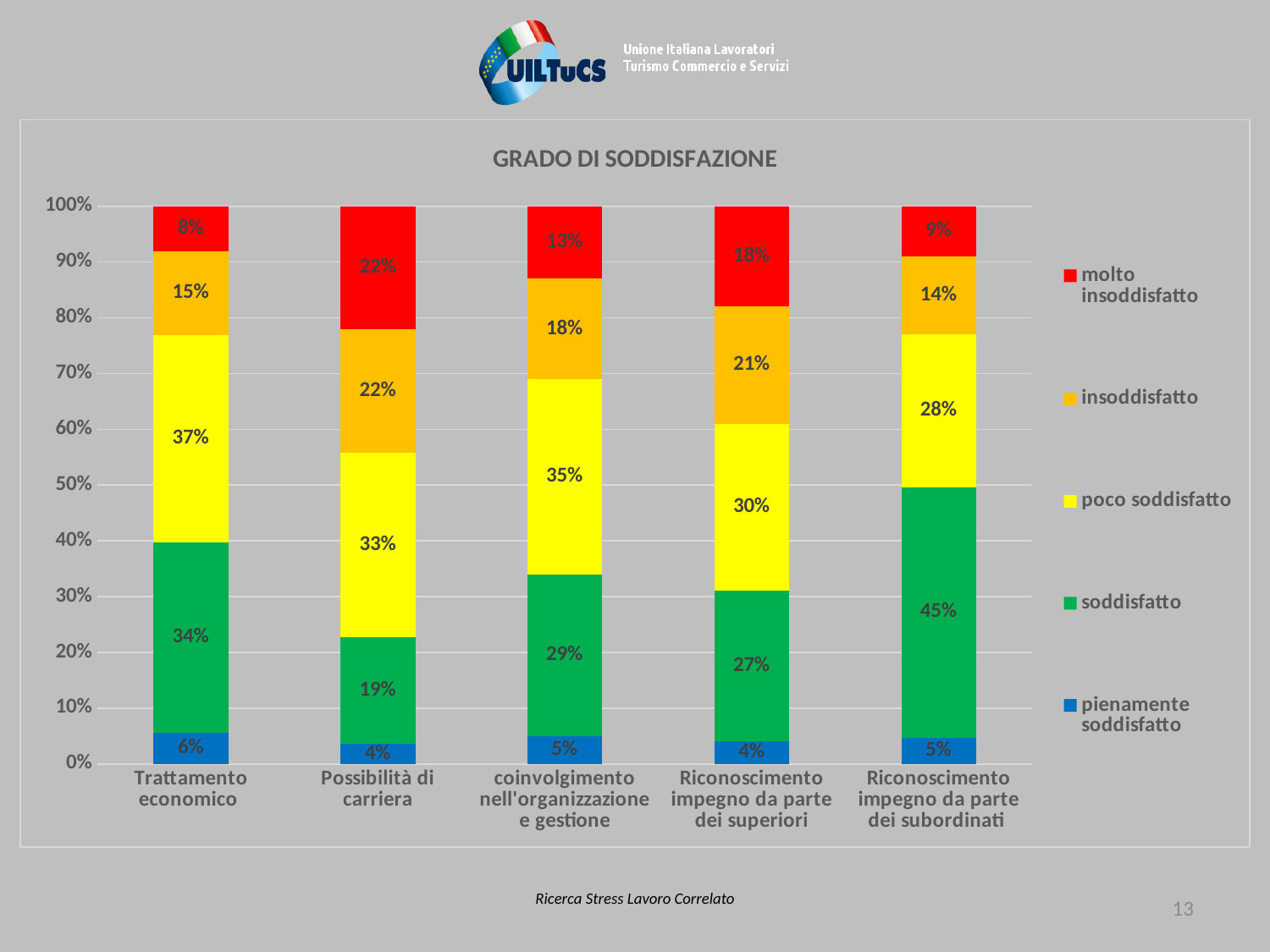
What kind of chart is shown on the slide? Stacked bar chart Which category has the highest 'soddisfatto' value? Riconoscimento impegno da parte dei subordinati What is the 'soddisfatto' value for 'Riconoscimento impegno da parte dei subordinati'? 45% Which is larger: the 'poco soddisfatto' value for 'coinvolgimento nell'organizzazione e gestione' or for 'Riconoscimento impegno da parte dei superiori'? coinvolgimento nell'organizzazione e gestione How many categories are shown on the x axis? 5 Which colour represents 'pienamente soddisfatto' in the legend? Blue Which category has the lowest 'molto insoddisfatto' value? Trattamento economico What is the 'poco soddisfatto' value for 'Trattamento economico'? 37% What is the 'molto insoddisfatto' value for 'Possibilità di carriera'? 22% How many series does the legend list? 5 What is the difference between the 'insoddisfatto' values for 'Possibilità di carriera' and 'Trattamento economico'? 7% What is the title of the chart? GRADO DI SODDISFAZIONE